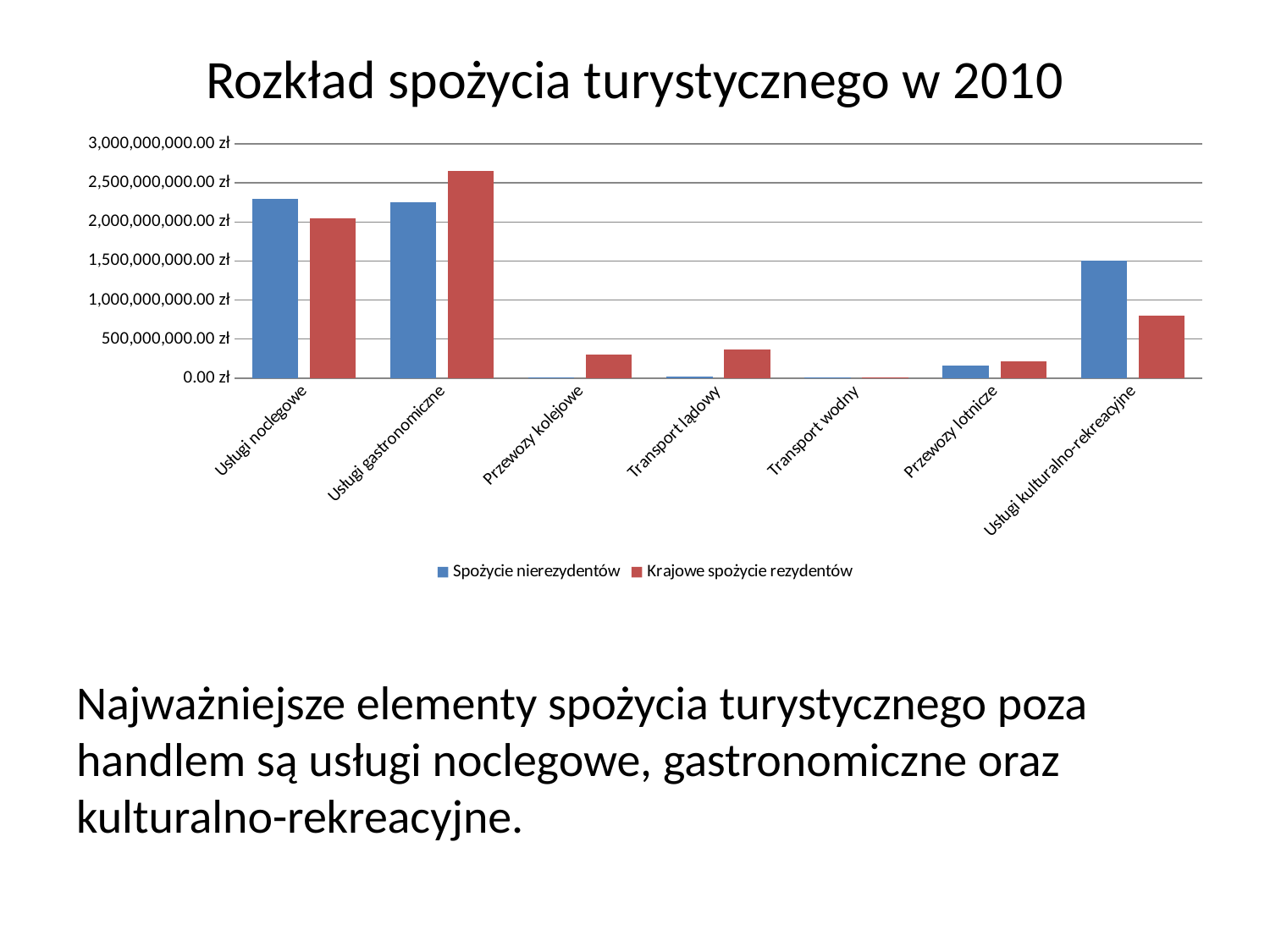
What kind of chart is shown on the slide? bar chart Is the value of Spożycie nierezydentów for Usługi noclegowe greater or less than 2,000,000,000.00 zł? greater What is the title of the chart? Rozkład spożycia turystycznego w 2010 Is the value of Krajowe spożycie rezydentów for Usługi gastronomiczne greater or less than 2,500,000,000.00 zł? greater How many series does the legend list? 2 How many categories are shown on the x axis? 7 For Usługi kulturalno-rekreacyjne, which is larger: Spożycie nierezydentów or Krajowe spożycie rezydentów? Spożycie nierezydentów Is the value of Krajowe spożycie rezydentów for Usługi kulturalno-rekreacyjne greater or less than 1,000,000,000.00 zł? less Which category has the lowest value for Krajowe spożycie rezydentów? Transport wodny For Usługi gastronomiczne, which is larger: Spożycie nierezydentów or Krajowe spożycie rezydentów? Krajowe spożycie rezydentów Which series is shown in red? Krajowe spożycie rezydentów Which category has the highest value for Krajowe spożycie rezydentów? Usługi gastronomiczne